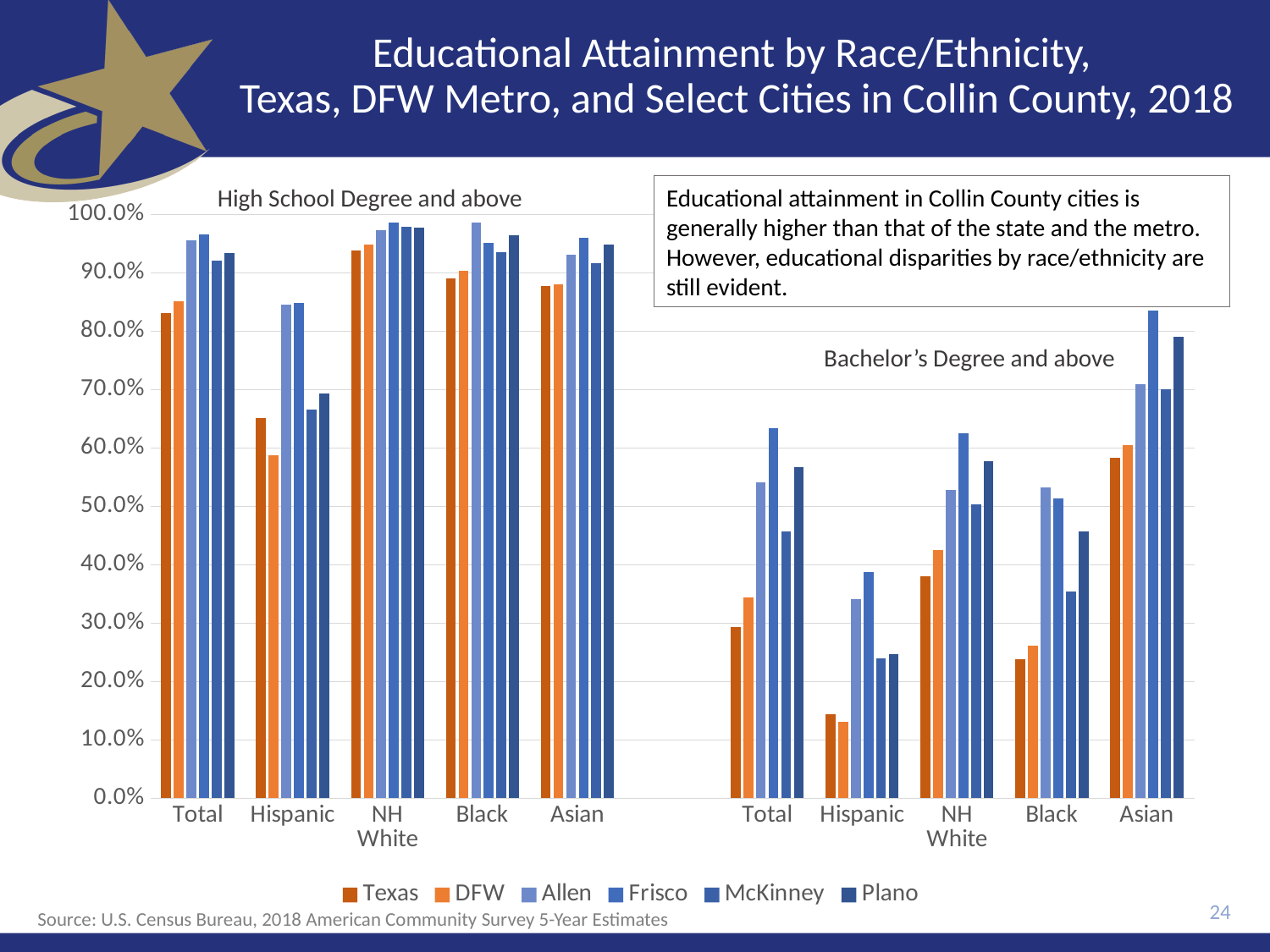
What is the source cited for the data on the slide? U.S. Census Bureau, 2018 American Community Survey 5-Year Estimates How many race/ethnicity categories are shown on the x axis of the "Bachelor's Degree and above" chart? 5 In the "Bachelor's Degree and above" chart, which category has the highest value for Texas? Asian In the "High School Degree and above" chart, is the value for Hispanic in Texas greater or less than 60%? greater In the "High School Degree and above" chart, which is larger for Hispanic: Texas or DFW? Texas In the "Bachelor's Degree and above" chart, which is larger for Total: Frisco or Texas? Frisco In the "Bachelor's Degree and above" chart, is the value for Black in Texas greater or less than 30%? less In the "Bachelor's Degree and above" chart, which category has the lowest value for Frisco? Hispanic What kind of chart is the "High School Degree and above" chart? bar chart How many series does the legend list? 6 In the "High School Degree and above" chart, which category has the lowest value for Texas? Hispanic In the "Bachelor's Degree and above" chart, is the value for Asian in Frisco greater or less than 80%? greater